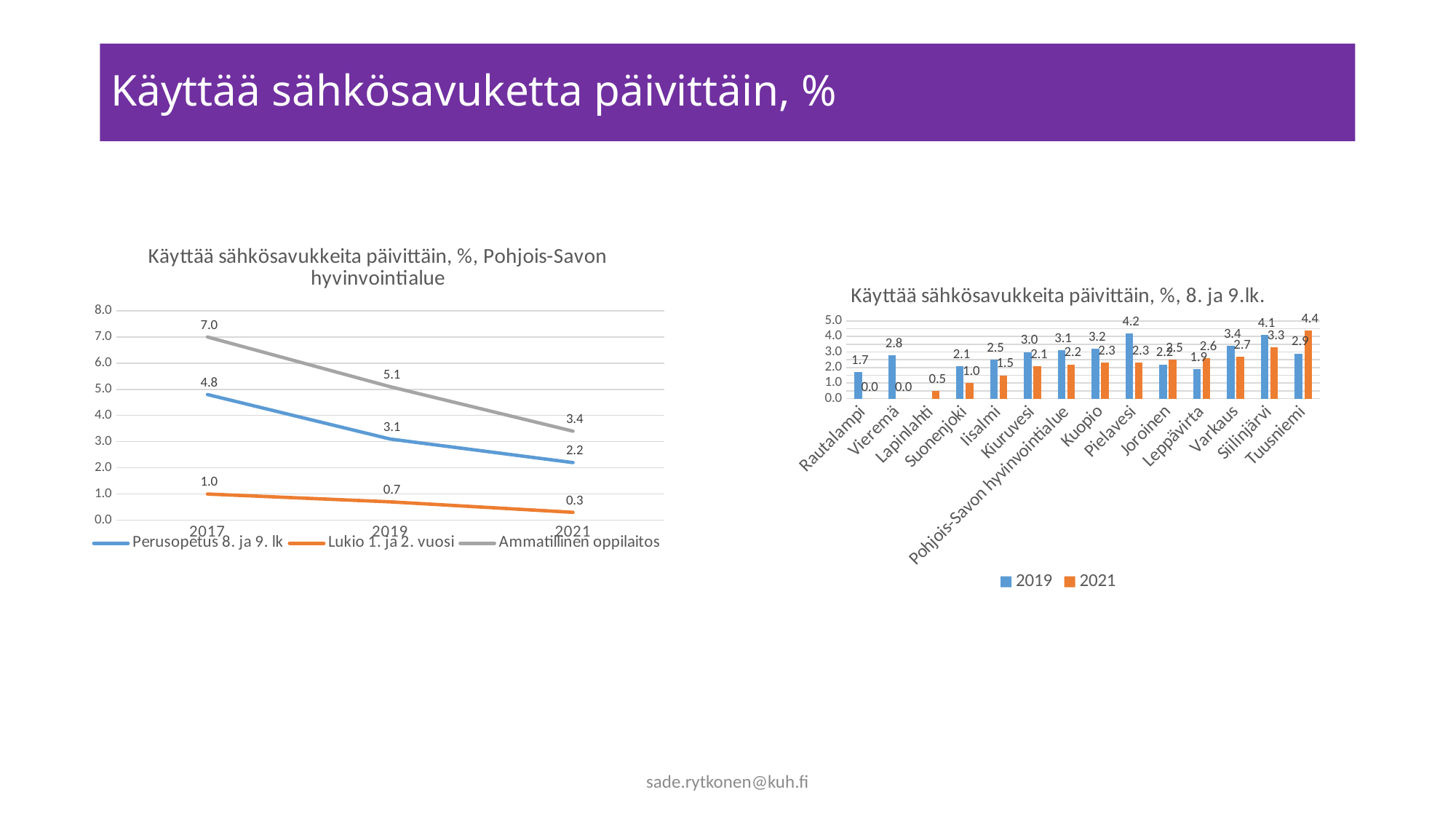
In the left chart (Pohjois-Savon hyvinvointialue), what is the value for Perusopetus 8. ja 9. lk in 2021? 2.2 In the right chart (8. ja 9.lk.), which category has the highest 2019 value? Pielavesi In the right chart (8. ja 9.lk.), which category has the highest 2021 value? Tuusniemi How many series does the legend of the left chart (Pohjois-Savon hyvinvointialue) list? 3 In the right chart (8. ja 9.lk.), which is larger for Leppävirta: the 2019 value or the 2021 value? 2021 What kind of chart is the left chart (Pohjois-Savon hyvinvointialue)? line chart In the right chart (8. ja 9.lk.), what is the difference between the 2019 and 2021 values for Pielavesi? 1.9 In the left chart (Pohjois-Savon hyvinvointialue), do the values for Ammatillinen oppilaitos rise or fall from 2017 to 2021? fall In the left chart (Pohjois-Savon hyvinvointialue), what is the value for Ammatillinen oppilaitos in 2017? 7.0 In the left chart (Pohjois-Savon hyvinvointialue), by how much did the Lukio 1. ja 2. vuosi value fall from 2017 to 2021? 0.7 In the right chart (8. ja 9.lk.), what is the 2021 value for Tuusniemi? 4.4 What kind of chart is the right chart (8. ja 9.lk.)? bar chart